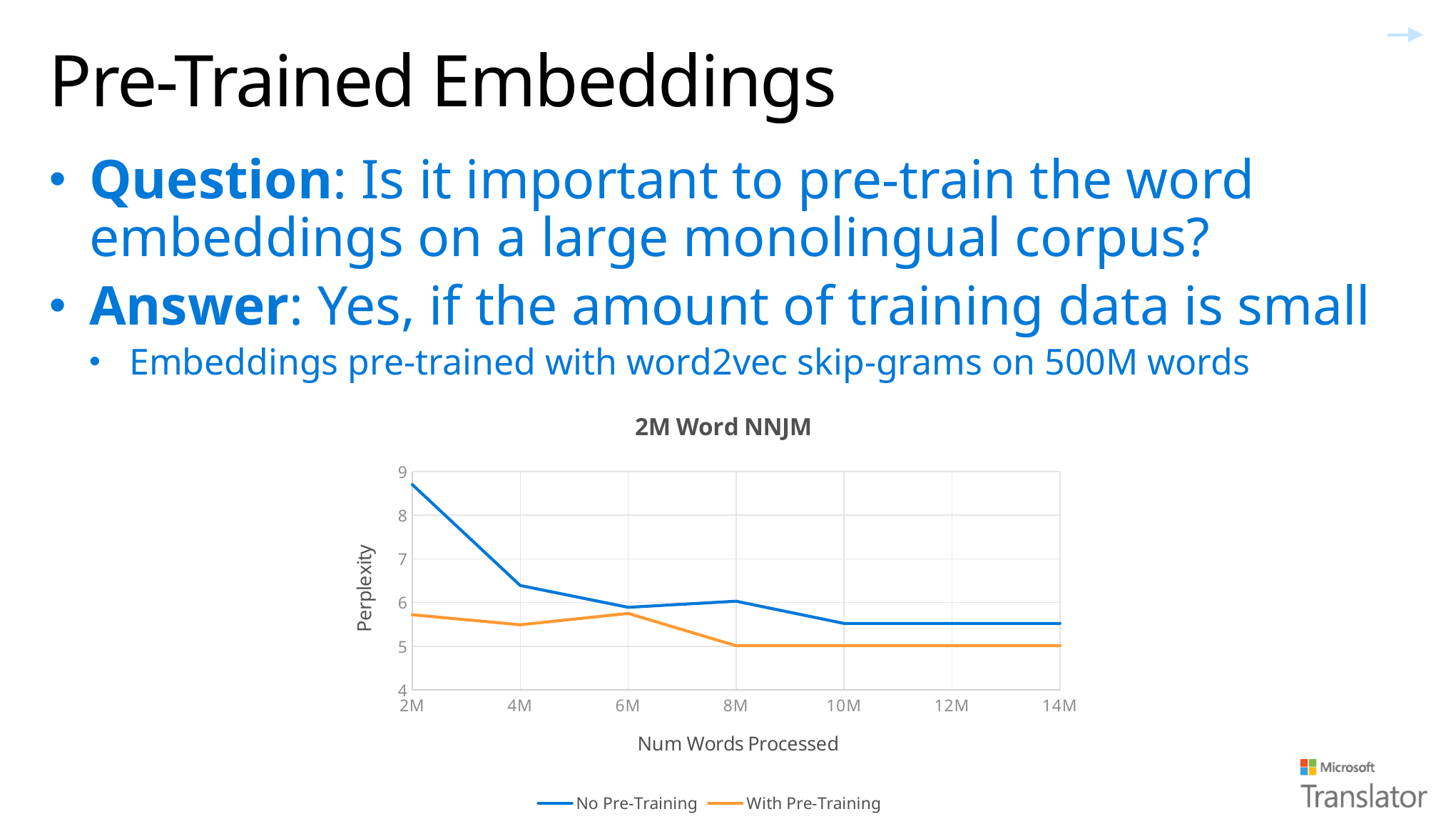
Is the No Pre-Training perplexity at 2M words processed greater or less than 8? greater How many series does the chart legend list? 2 Is the With Pre-Training perplexity at 14M words processed greater or less than 6? less How many points are plotted along the x axis for each series? 7 Does the No Pre-Training perplexity generally rise or fall as the number of words processed increases? fall What is the label of the y axis? Perplexity At 8M words processed, which series has the higher perplexity? No Pre-Training Is the No Pre-Training perplexity at 4M words processed greater or less than 6? greater At which number of words processed does the No Pre-Training series reach its highest perplexity? 2M What is the title of the chart? 2M Word NNJM What kind of chart is shown on the slide? Line chart